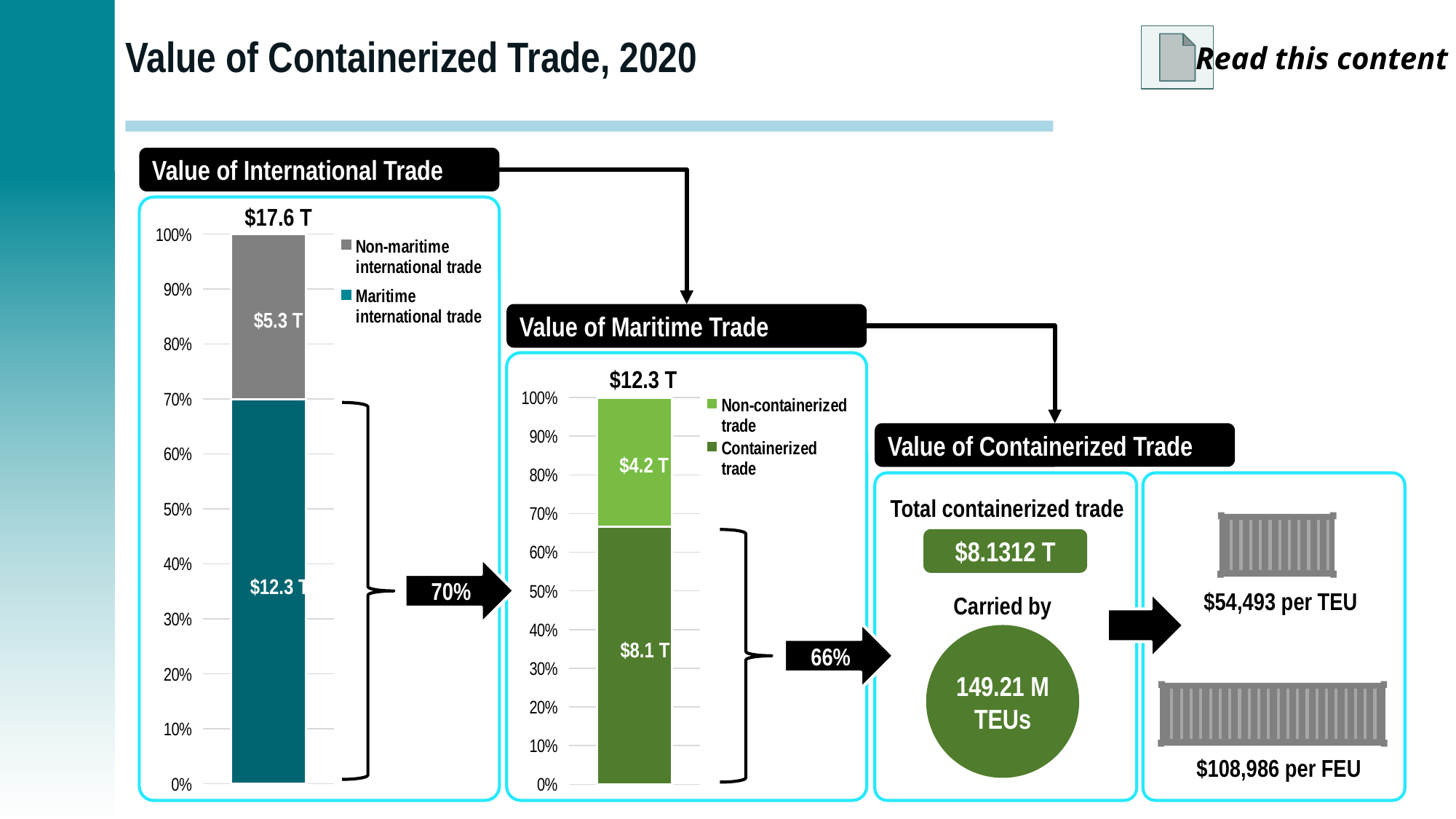
In the Value of Maritime Trade chart, is the top of the containerized trade segment greater or less than 60%? greater In the Value of International Trade chart, what is the value of non-maritime international trade? $5.3 T In the Value of Maritime Trade chart, what is the value of containerized trade? $8.1 T In the Value of International Trade chart, what is the value of maritime international trade? $12.3 T What kind of chart is the Value of Maritime Trade chart? Stacked bar chart In the Value of Maritime Trade chart, what is the value of non-containerized trade? $4.2 T In the Value of International Trade chart, what is the total value shown above the stacked bar? $17.6 T In the Value of International Trade chart, which is larger: maritime international trade or non-maritime international trade? Maritime international trade In the Value of International Trade chart, how many series does the legend list? 2 In the Value of Maritime Trade chart, what is the total value shown above the stacked bar? $12.3 T In the Value of International Trade chart, what is the difference between maritime and non-maritime international trade? $7.0 T In the Value of Maritime Trade chart, what colour represents containerized trade? Dark green